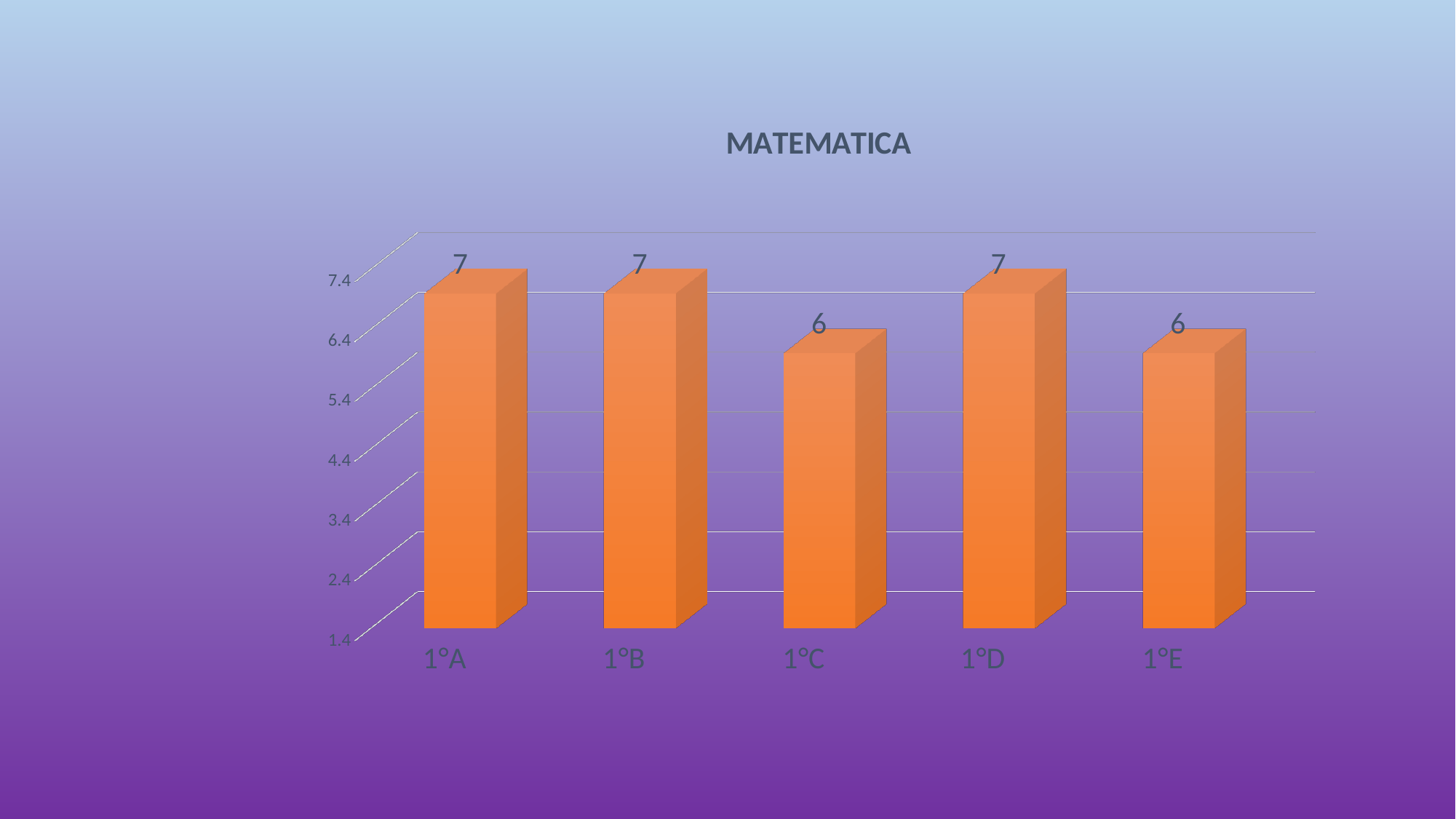
Is the value for 1°C greater or less than 6.4? less Is the value for 1°D larger than the value for 1°E? Yes What kind of chart is shown on the slide? Bar chart What is the value for 1°A? 7 What is the title of the chart? MATEMATICA What colour are the bars in the chart? Orange What is the value for 1°E? 6 What is the value for 1°C? 6 How many categories are shown on the x axis? 5 Which category has the lowest value, 1°B or 1°C? 1°C What is the value for 1°D? 7 What is the difference between the values for 1°A and 1°C? 1